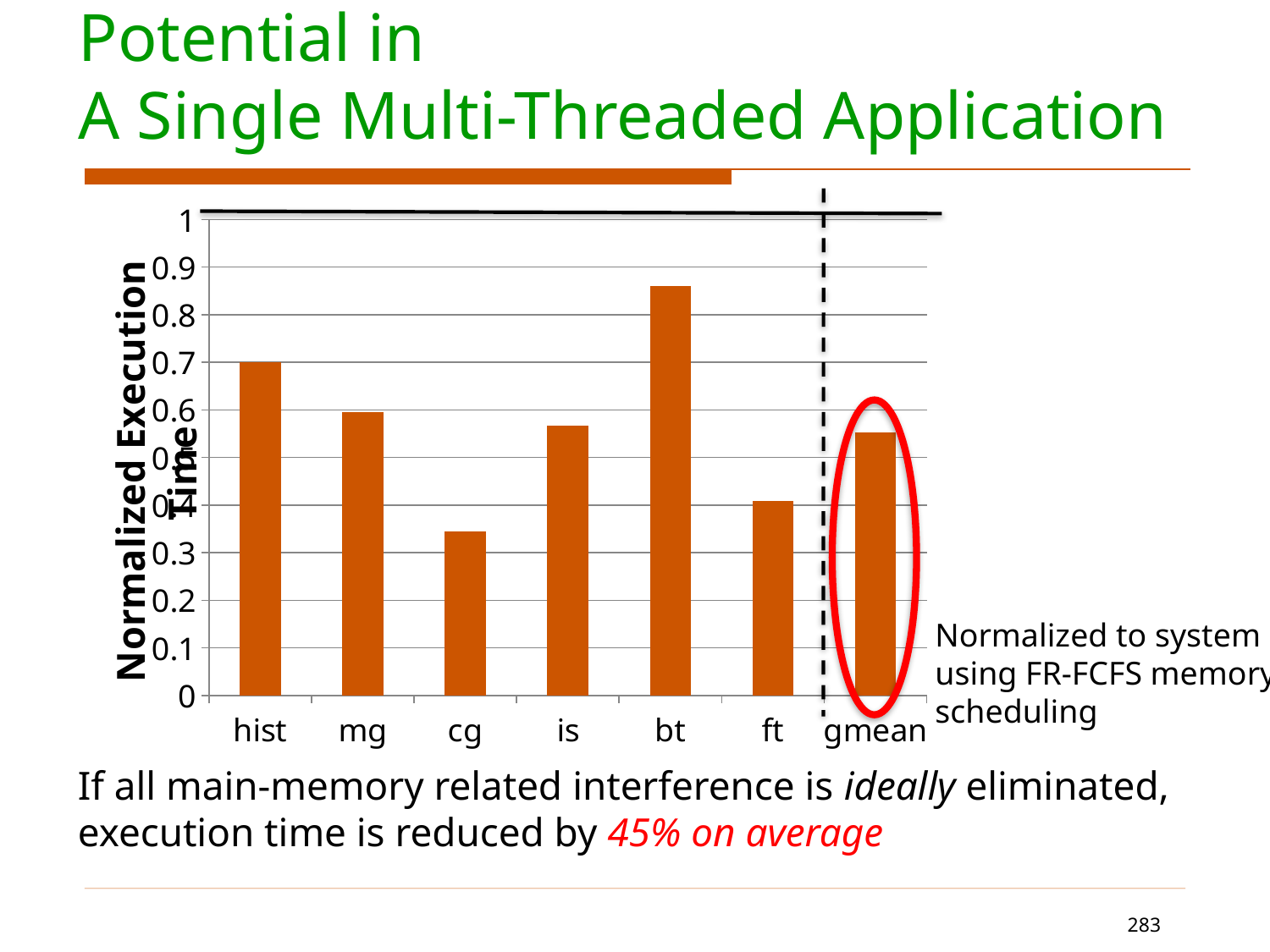
Is the value for gmean greater or less than 0.5? greater What kind of chart is shown on the slide? bar chart Which category's bar is circled in red? gmean Which has a larger normalized execution time, bt or ft? bt Is the value for cg greater or less than 0.4? less Which has a larger normalized execution time, hist or mg? hist Which category has the highest normalized execution time? bt Which category has the lowest normalized execution time? cg What is the normalized execution time for hist? 0.7 Is the value for bt greater or less than 0.8? greater What is the label of the y axis? Normalized Execution Time How many categories are plotted on the x axis? 7